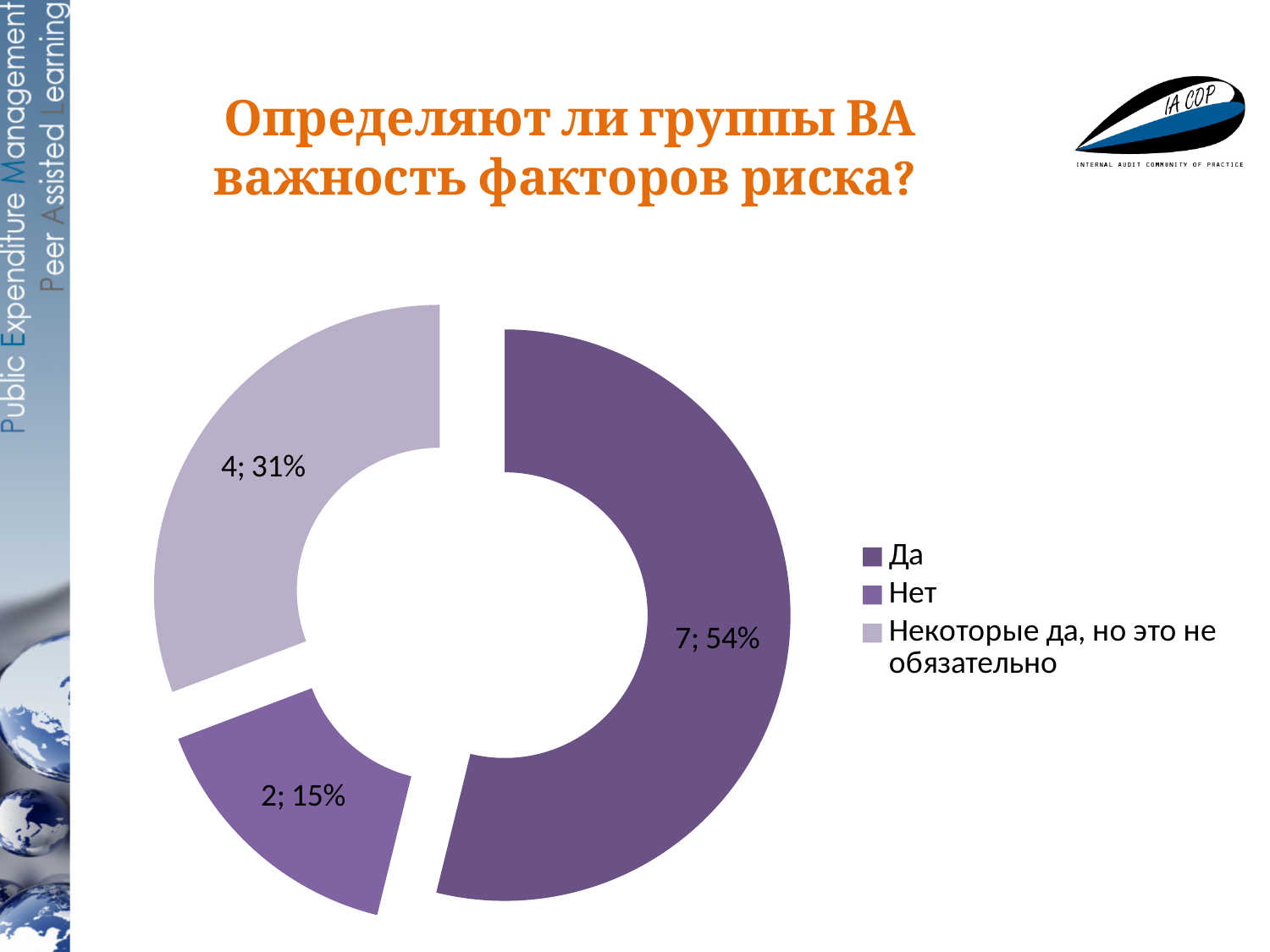
Which category has the smallest share? Нет What is the total number of respondents across all categories? 13 What is the difference in count between "Да" and "Нет"? 5 What is the title of the slide containing the chart? Определяют ли группы ВА важность факторов риска? Which has a larger share, "Нет" or "Некоторые да, но это не обязательно"? Некоторые да, но это не обязательно How many respondents answered "Да"? 7 What kind of chart is shown on the slide? Doughnut (pie) chart How many categories does the chart show? 3 What percentage share does "Нет" have? 15% How many respondents answered "Некоторые да, но это не обязательно"? 4 What percentage share does "Да" have? 54% Which category has the largest share? Да